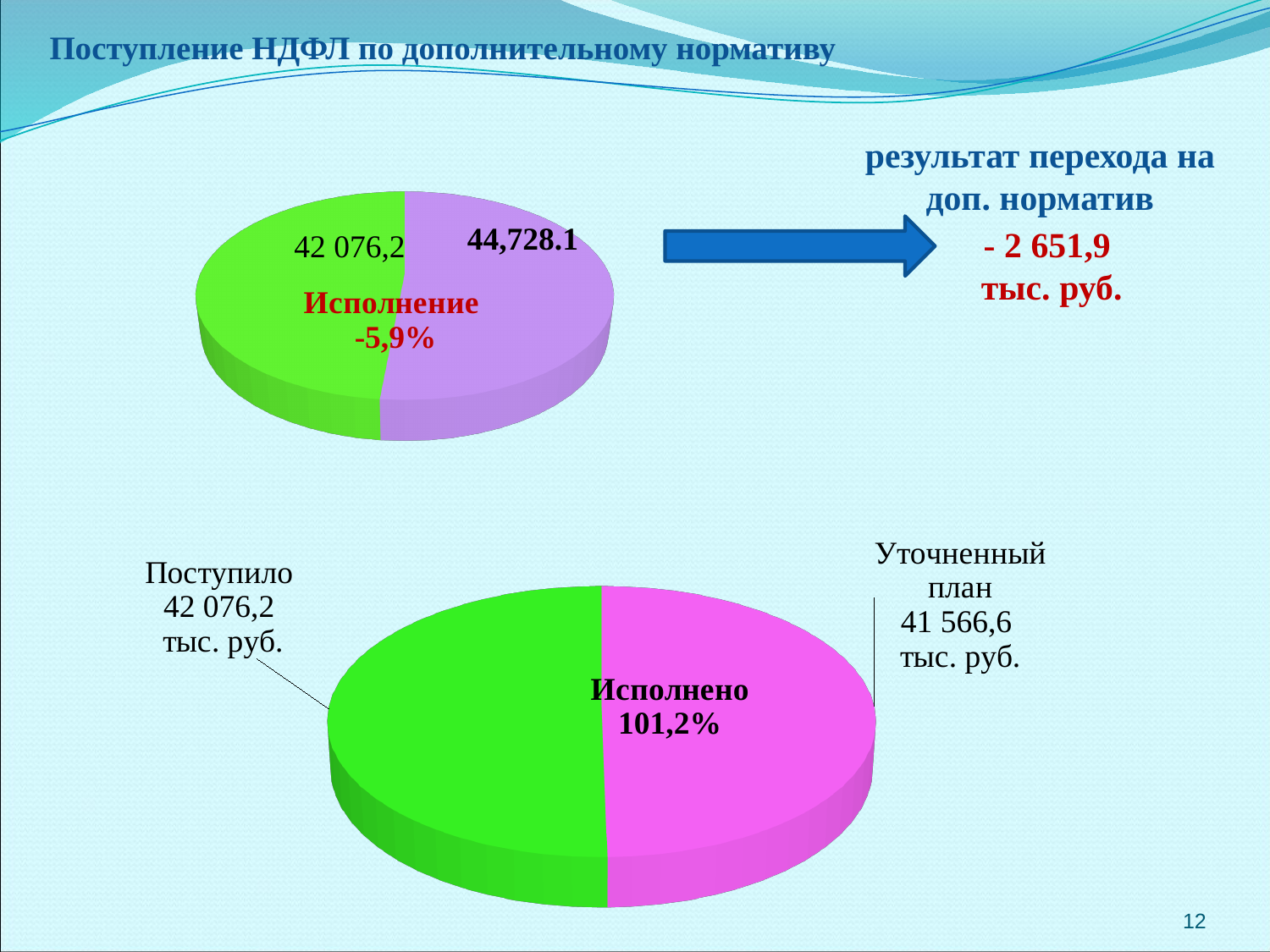
In the bottom pie chart, what is the difference between Поступило (42 076,2) and Уточненный план (41 566,6)? 509,6 In the top pie chart, which slice has the larger value, the purple one or the green one? Purple In the top pie chart, what value is printed on the purple slice? 44,728.1 What kind of chart is the bottom chart on the slide? Pie chart In the top pie chart, what value is printed on the green slice? 42 076,2 In the bottom pie chart, what is the value for Поступило? 42 076,2 тыс. руб. What text is printed in the centre of the top pie chart? Исполнение -5,9% What kind of chart is the top chart on the slide? Pie chart In the top pie chart, what is the difference between the purple slice value (44,728.1) and the green slice value (42 076,2)? 2 651,9 In the bottom pie chart, what is the value for Уточненный план? 41 566,6 тыс. руб. In the bottom pie chart, which is larger, Поступило or Уточненный план? Поступило How many slices does the bottom pie chart have? 2